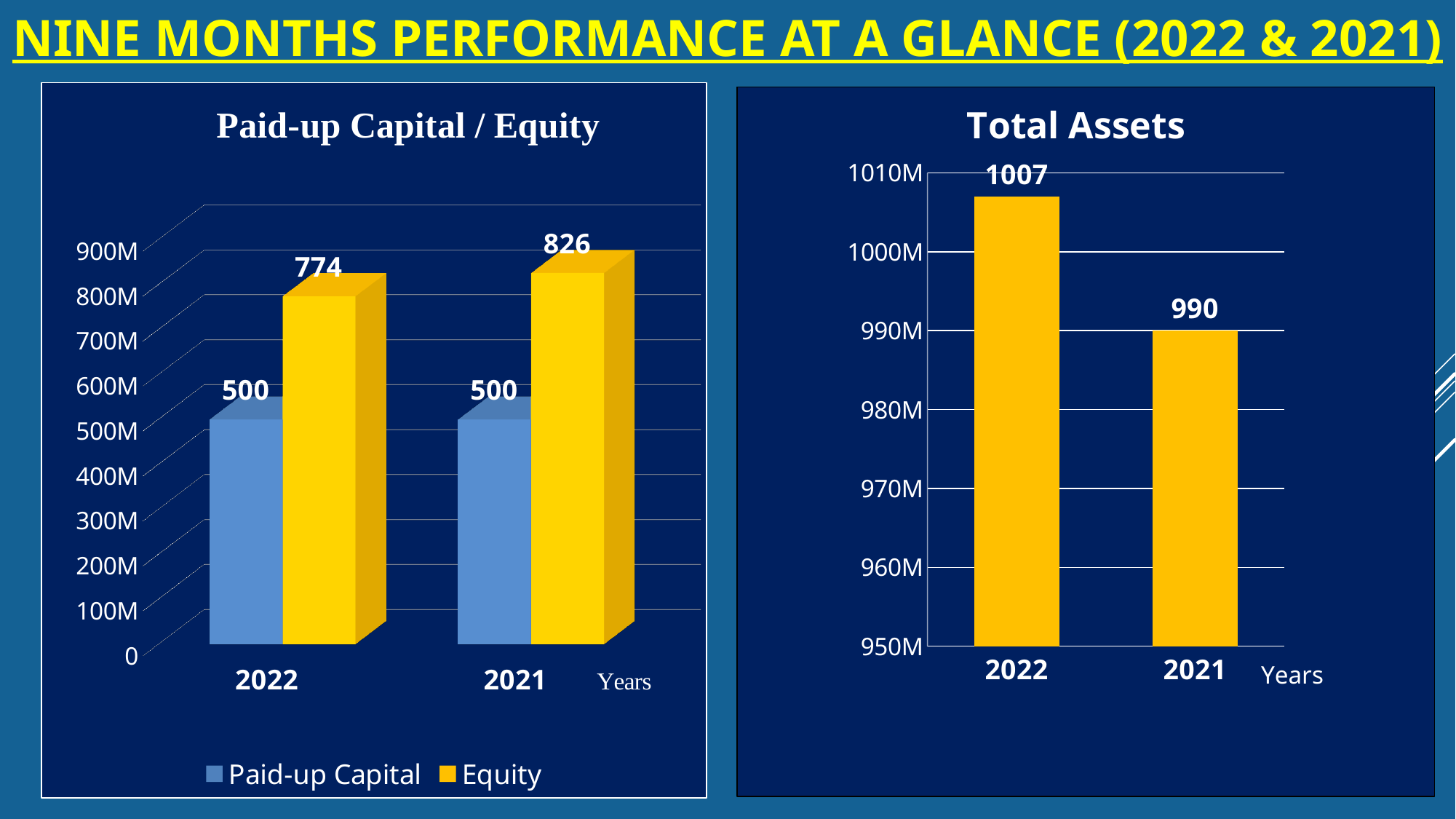
In the Paid-up Capital / Equity chart, what is the Equity value for 2022? 774 In the Total Assets chart, what is the value for 2022? 1007 How many series does the legend of the Paid-up Capital / Equity chart list? 2 In the Paid-up Capital / Equity chart, which year has the higher Equity value? 2021 In the Paid-up Capital / Equity chart, what is the Paid-up Capital value for 2022? 500 In the Paid-up Capital / Equity chart, which colour represents Equity? Yellow In the Total Assets chart, which year has the highest value? 2022 In the Total Assets chart, what is the value for 2021? 990 What kind of chart is the Total Assets chart? Bar chart In the Total Assets chart, what is the difference between the 2022 and 2021 values? 17 In the Paid-up Capital / Equity chart, what is the difference between the Equity values for 2021 and 2022? 52 In the Paid-up Capital / Equity chart, what is the Equity value for 2021? 826